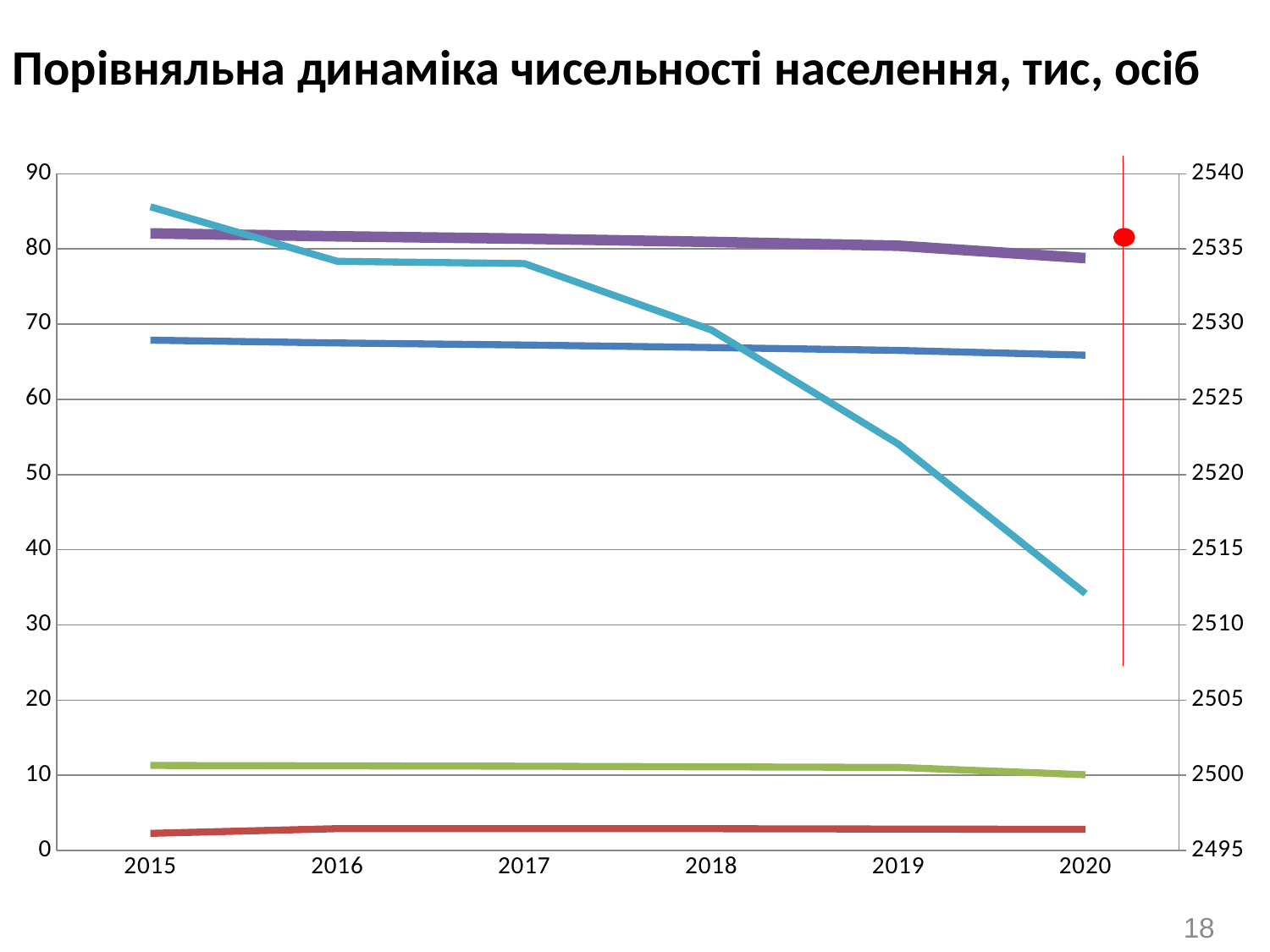
Does the light blue line rise or fall from 2015 to 2020? fall What is the title of the chart? Порівняльна динаміка чисельності населення, тис, осіб In which year is the light blue line at its lowest? 2020 Is the value of the red line in 2020 greater or less than 10 on the left axis? less In which year is the light blue line at its highest? 2015 Which is larger for the light blue line: its value in 2015 or its value in 2020? 2015 Is the value of the dark blue line in 2015 greater or less than 70 on the left axis? less How many lines are plotted on the chart? 5 How many years are shown along the x axis of the chart? 6 Is the value of the light blue line in 2015 greater or less than 80 on the left axis? greater What kind of chart is shown on the slide? line chart